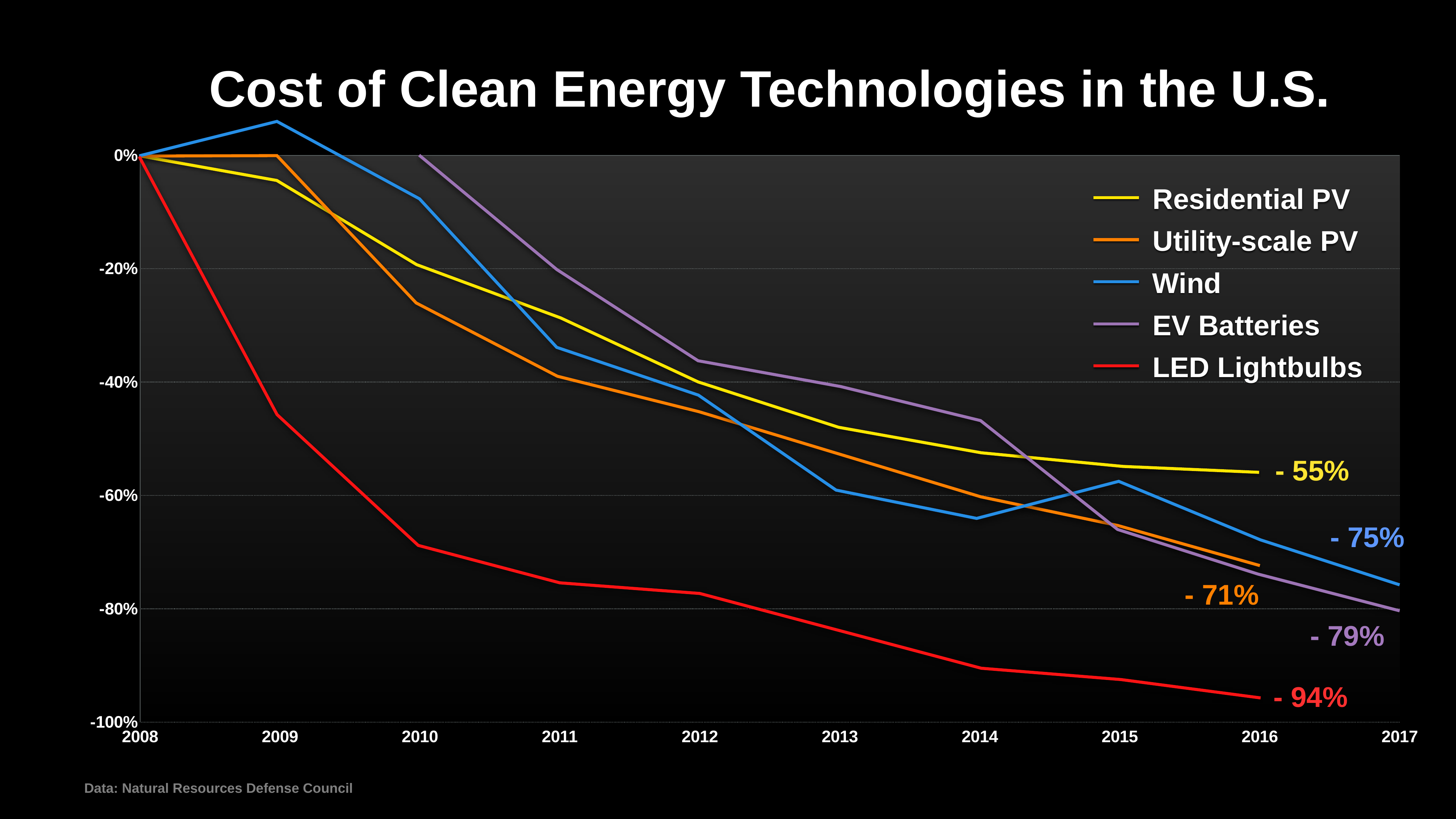
What is the labelled final value for Residential PV? - 55% What is the labelled final value for Wind? - 75% How many years are shown on the x axis? 10 Is the value for LED Lightbulbs in 2010 greater or less than -60%? less What kind of chart is shown on the slide? line chart Which technology shows the largest cost decline by the end of the chart? LED Lightbulbs What is the labelled final value for EV Batteries? - 79% Which technology shows the smallest cost decline by the end of the chart? Residential PV What is the labelled final value for LED Lightbulbs? - 94% What is the labelled final value for Utility-scale PV? - 71% How many series does the legend list? 5 By how many percentage points does the final decline for LED Lightbulbs exceed that of Residential PV? 39 percentage points